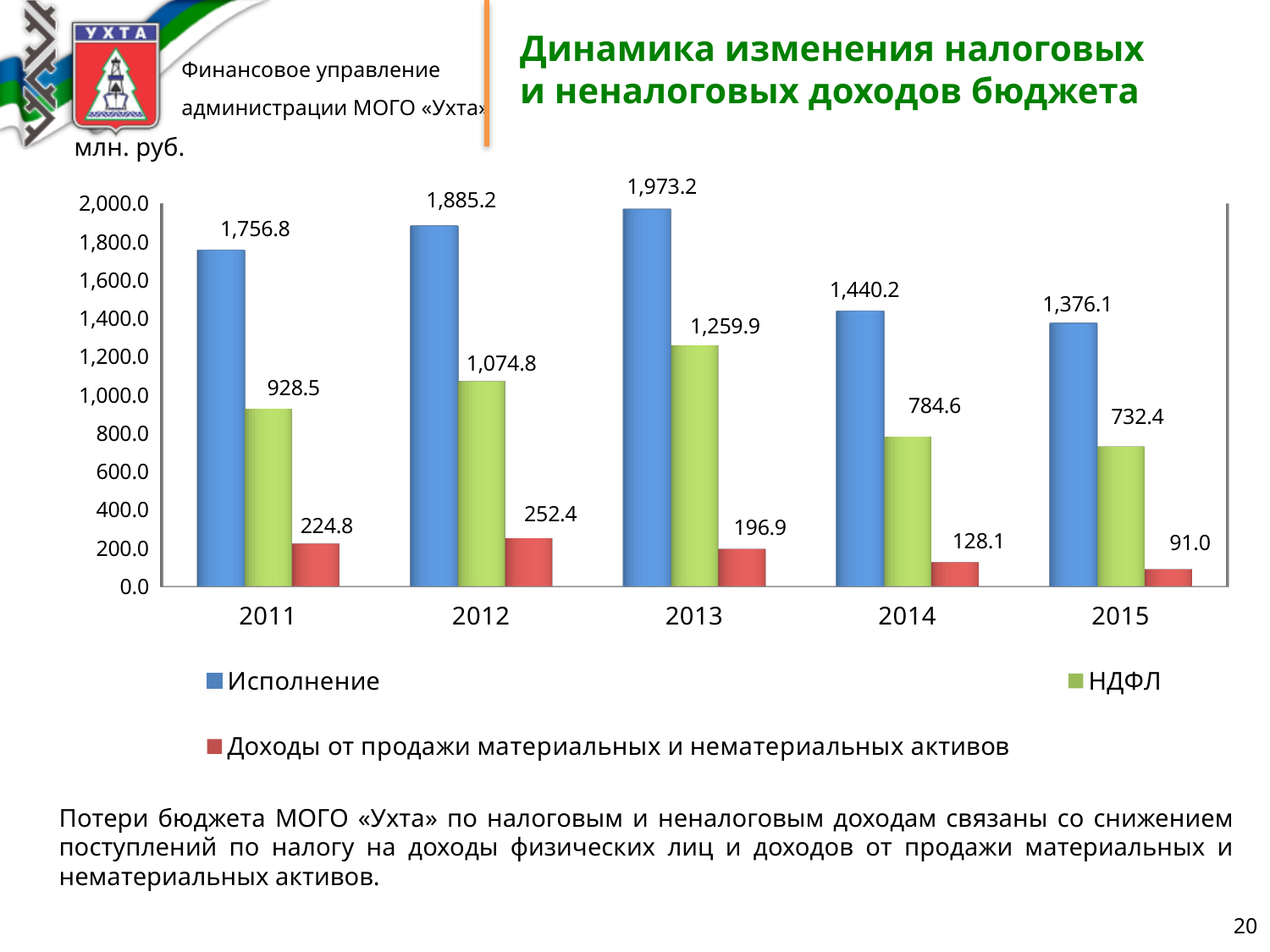
What is the value of Исполнение for 2013? 1,973.2 What unit is indicated above the chart? млн. руб. In which year is НДФЛ the lowest? 2015 What is the difference between Исполнение in 2013 and Исполнение in 2015? 597.1 In which year is Исполнение the highest? 2013 What kind of chart is shown on the slide? Bar chart Does Доходы от продажи материальных и нематериальных активов rise or fall from 2013 to 2015? Fall Which is larger: НДФЛ in 2011 or НДФЛ in 2014? НДФЛ in 2011 What is the value of НДФЛ for 2012? 1,074.8 How many years are shown on the x axis? 5 What is the value of Доходы от продажи материальных и нематериальных активов for 2015? 91.0 How many series does the legend list? 3